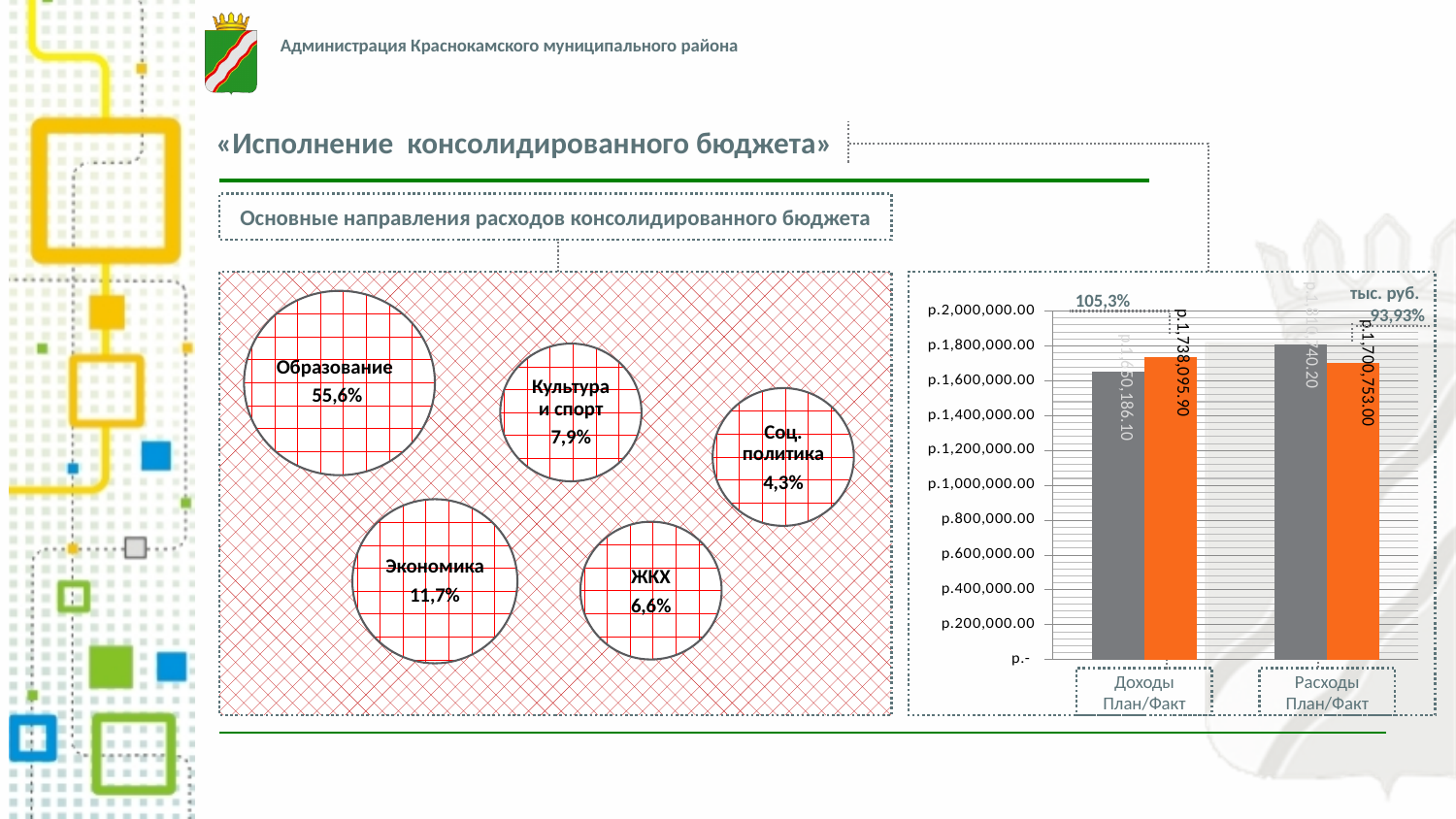
In the bar chart on the right, is the План (grey) bar for Доходы greater or less than р.1,600,000.00? greater In the left diagram 'Основные направления расходов консолидированного бюджета', which direction has the largest share? Образование (55,6%) In the bar chart on the right, how many categories are shown on the x axis? 2 In the bar chart on the right, what is the value of the Факт (orange) bar for Расходы? р.1,700,753.00 In the bar chart on the right, what percentage is printed above the Расходы bars? 93,93% In the bar chart on the right, which is larger: the Факт value for Доходы or the Факт value for Расходы? Доходы What kind of chart is shown on the right side of the slide? bar chart In the bar chart on the right, what is the difference between the Факт value for Доходы and the Факт value for Расходы? р.37,342.90 In the bar chart on the right, what percentage is printed above the Доходы bars? 105,3% In the bar chart on the right, for Расходы, which bar is taller: План or Факт? План In the bar chart on the right, what is the value of the Факт (orange) bar for Доходы? р.1,738,095.90 In the left diagram 'Основные направления расходов консолидированного бюджета', what share is shown for Экономика? 11,7%